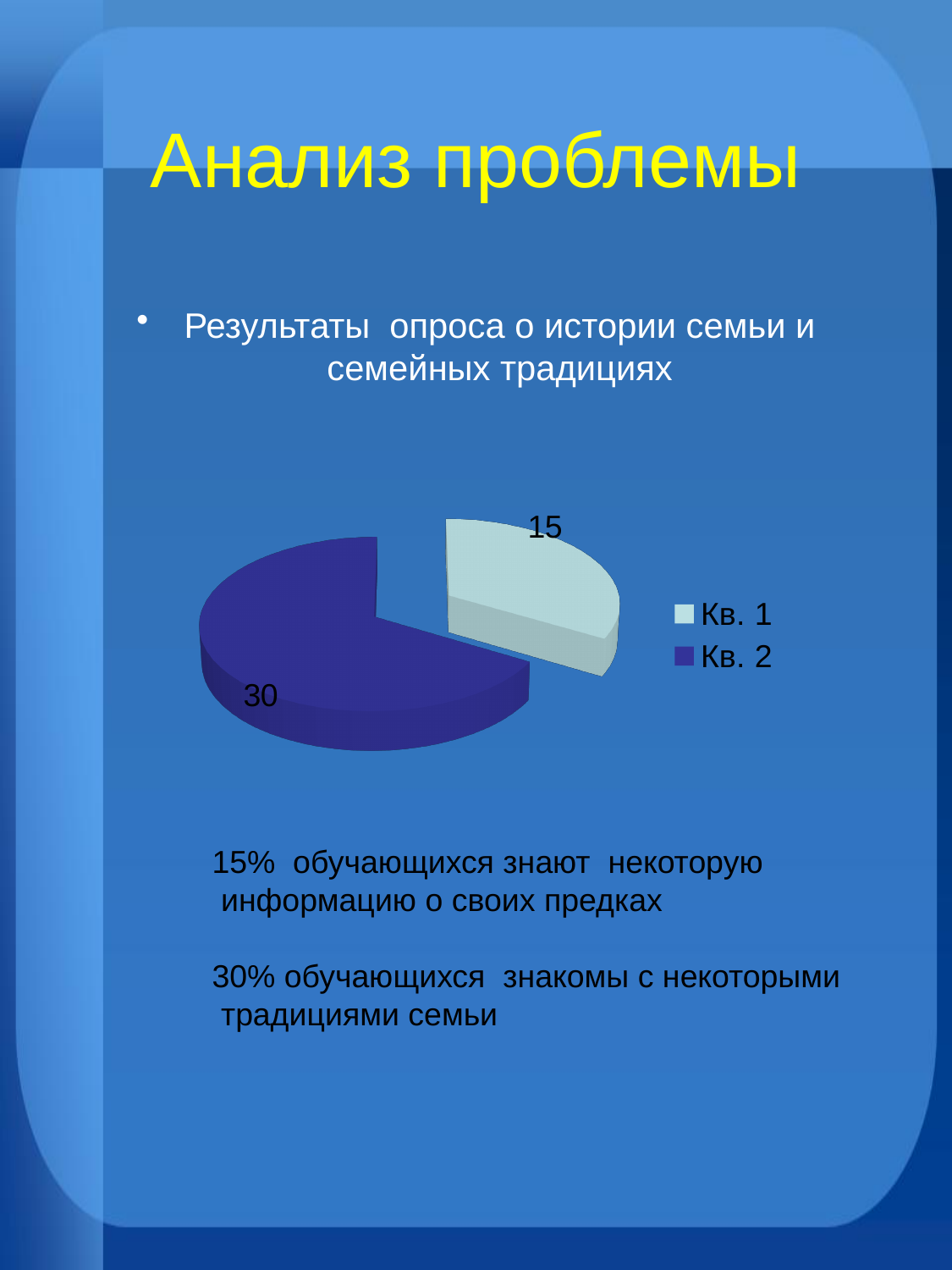
Which slice of the pie chart is the smallest? Кв. 1 What is the value shown for Кв. 2 in the pie chart? 30 Which slice of the pie chart is the largest? Кв. 2 What share of the pie does the Кв. 2 slice represent? two thirds What is the total of the two values shown in the pie chart? 45 What is the difference between the values for Кв. 2 and Кв. 1? 15 What kind of chart is shown on the slide? pie chart Which is larger, the value for Кв. 1 or the value for Кв. 2? Кв. 2 What colour is the Кв. 2 slice in the pie chart? dark blue How many entries does the legend of the pie chart list? 2 How many slices does the pie chart have? 2 What is the value shown for Кв. 1 in the pie chart? 15